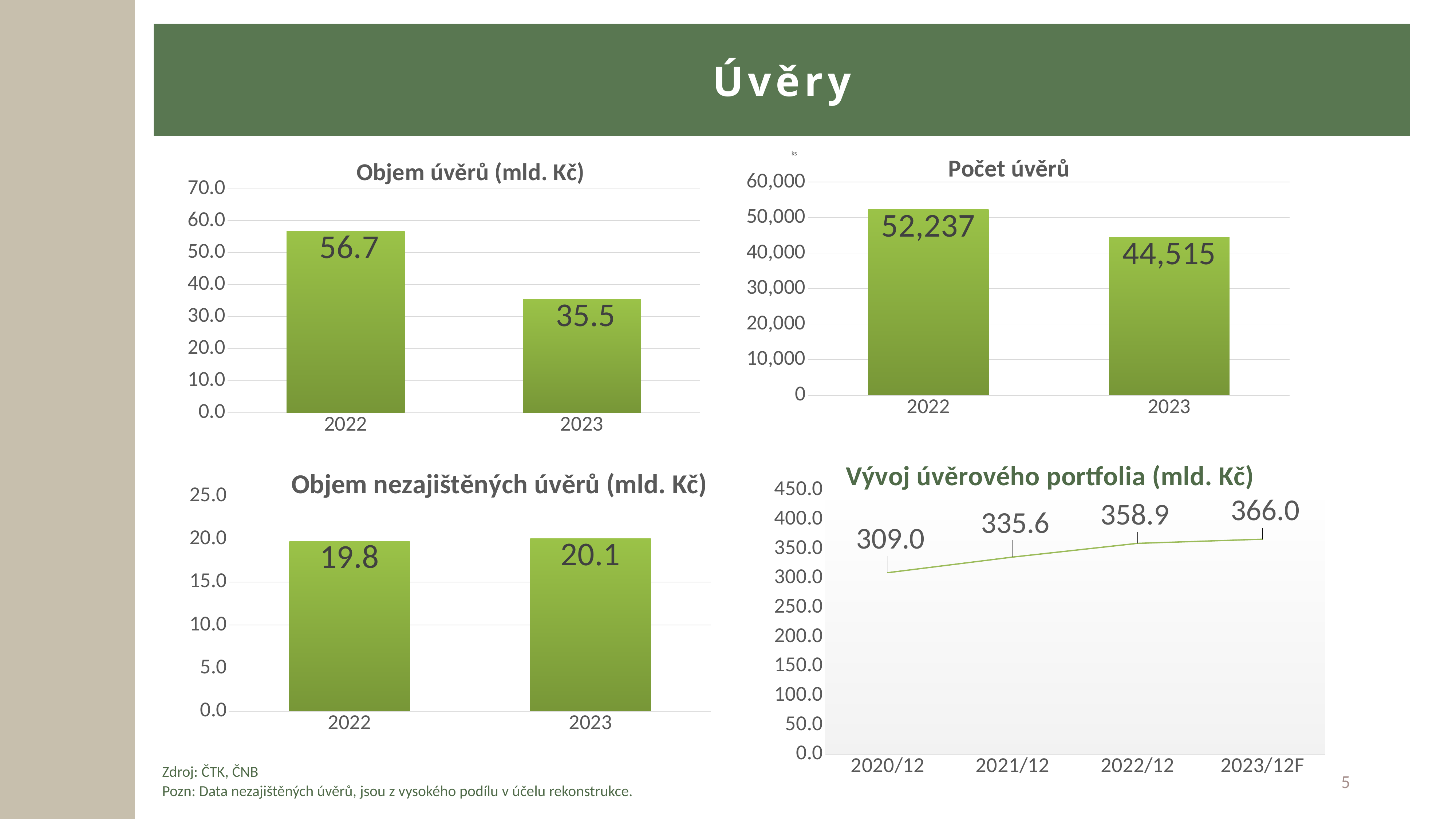
In the chart titled "Objem úvěrů (mld. Kč)", what is the value for 2022? 56.7 In the chart titled "Vývoj úvěrového portfolia (mld. Kč)", do the values rise or fall from 2020/12 to 2023/12F? rise In the chart titled "Objem úvěrů (mld. Kč)", what is the difference between the 2022 and 2023 values? 21.2 In the chart titled "Objem nezajištěných úvěrů (mld. Kč)", what is the value for 2023? 20.1 In the chart titled "Počet úvěrů", by how much does the 2022 value exceed the 2023 value? 7,722 What kind of chart is the one titled "Vývoj úvěrového portfolia (mld. Kč)"? line chart In the chart titled "Počet úvěrů", which year has the higher value? 2022 In the chart titled "Počet úvěrů", what is the value for 2023? 44,515 In the chart titled "Vývoj úvěrového portfolia (mld. Kč)", what is the difference between the 2023/12F and 2020/12 values? 57.0 In the chart titled "Vývoj úvěrového portfolia (mld. Kč)", how many data points are plotted? 4 In the chart titled "Vývoj úvěrového portfolia (mld. Kč)", what is the value for 2021/12? 335.6